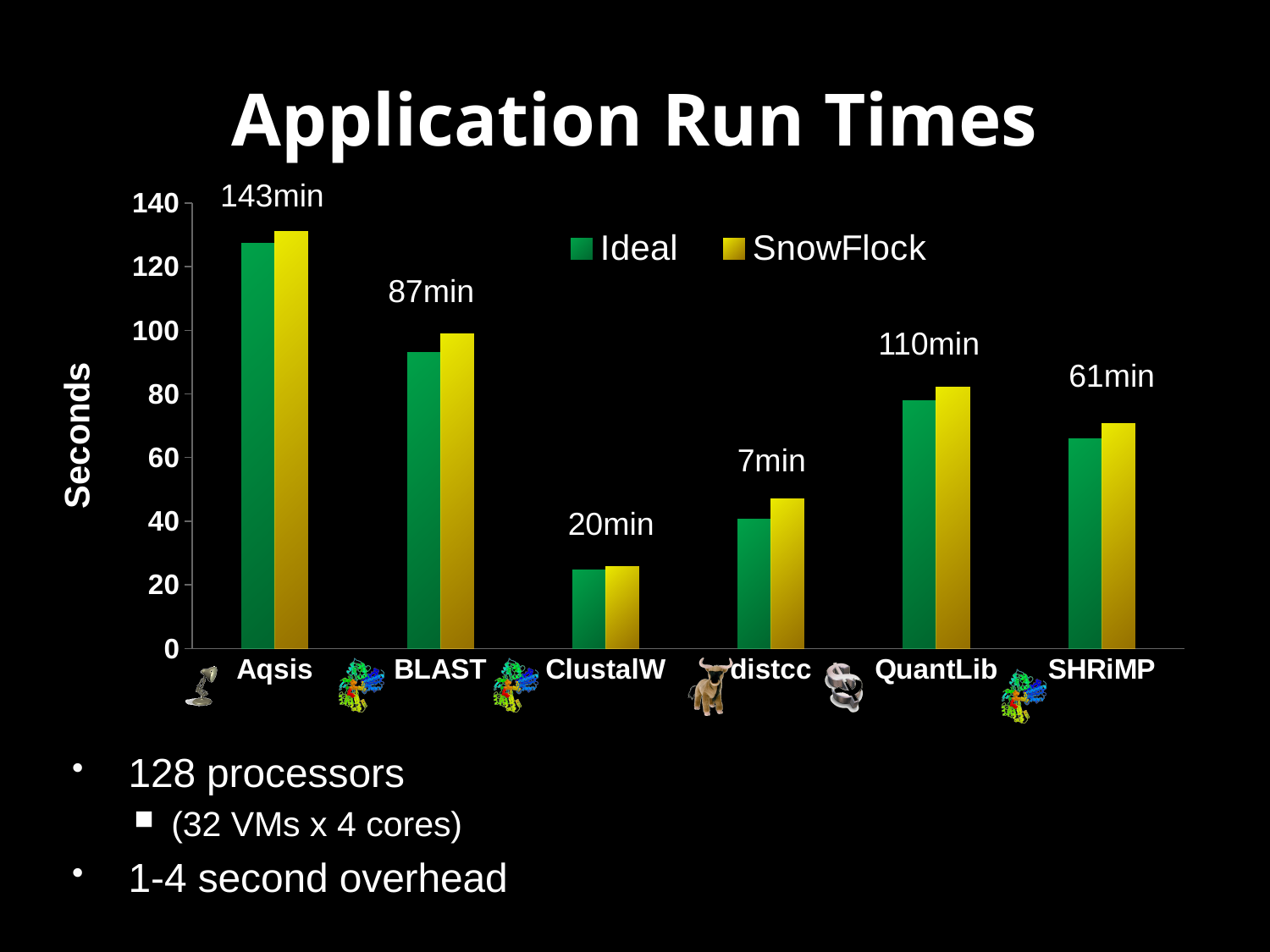
What is the label on the vertical axis? Seconds What kind of chart is shown on the slide? bar chart How many applications (categories) are shown on the x axis? 6 Which application has the highest Ideal run time? Aqsis Is the SnowFlock value for Aqsis greater or less than 120? greater Is the SnowFlock value for distcc greater or less than 40? greater How many series does the legend list? 2 Is the Ideal value for ClustalW greater or less than 40? less Which application has the lowest SnowFlock run time? ClustalW Which is larger, the SnowFlock value for QuantLib or the SnowFlock value for SHRiMP? QuantLib What annotation is printed above the Aqsis bars? 143min